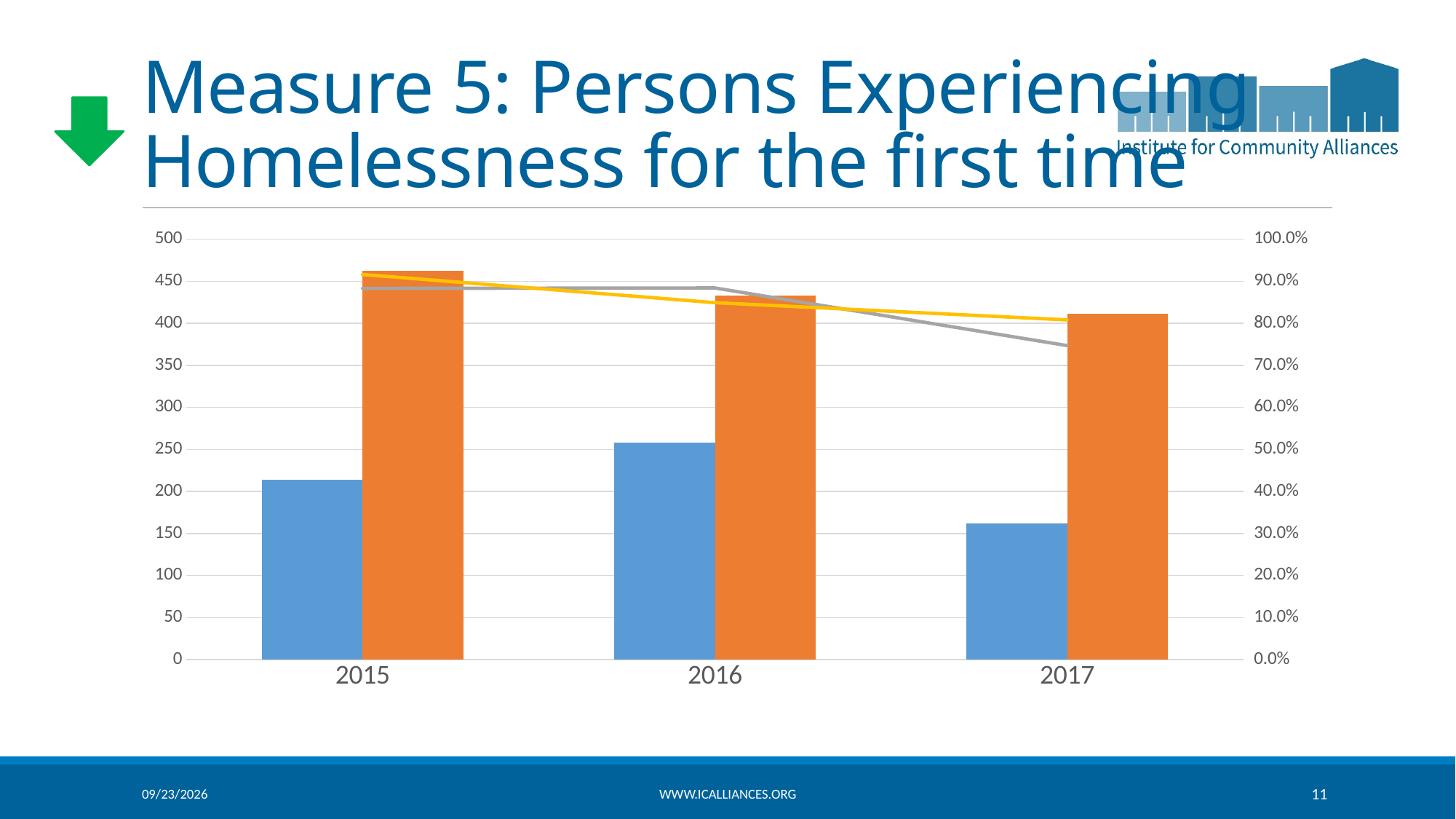
In 2015, which bar is taller, the blue bar or the orange bar? the orange bar Is the value of the blue bar for 2016 greater or less than 250? greater Which year has the shortest blue bar? 2017 Is the value of the blue bar for 2017 greater or less than 200? less Is the value of the orange bar for 2015 greater or less than 450? greater Which year has the shortest orange bar? 2017 Do the orange bars rise or fall from 2015 to 2017? fall How many years are shown on the x axis of the chart? 3 Which year has the tallest orange bar? 2015 Which year has the tallest blue bar? 2016 What kind of chart is shown on the slide? combination bar and line chart